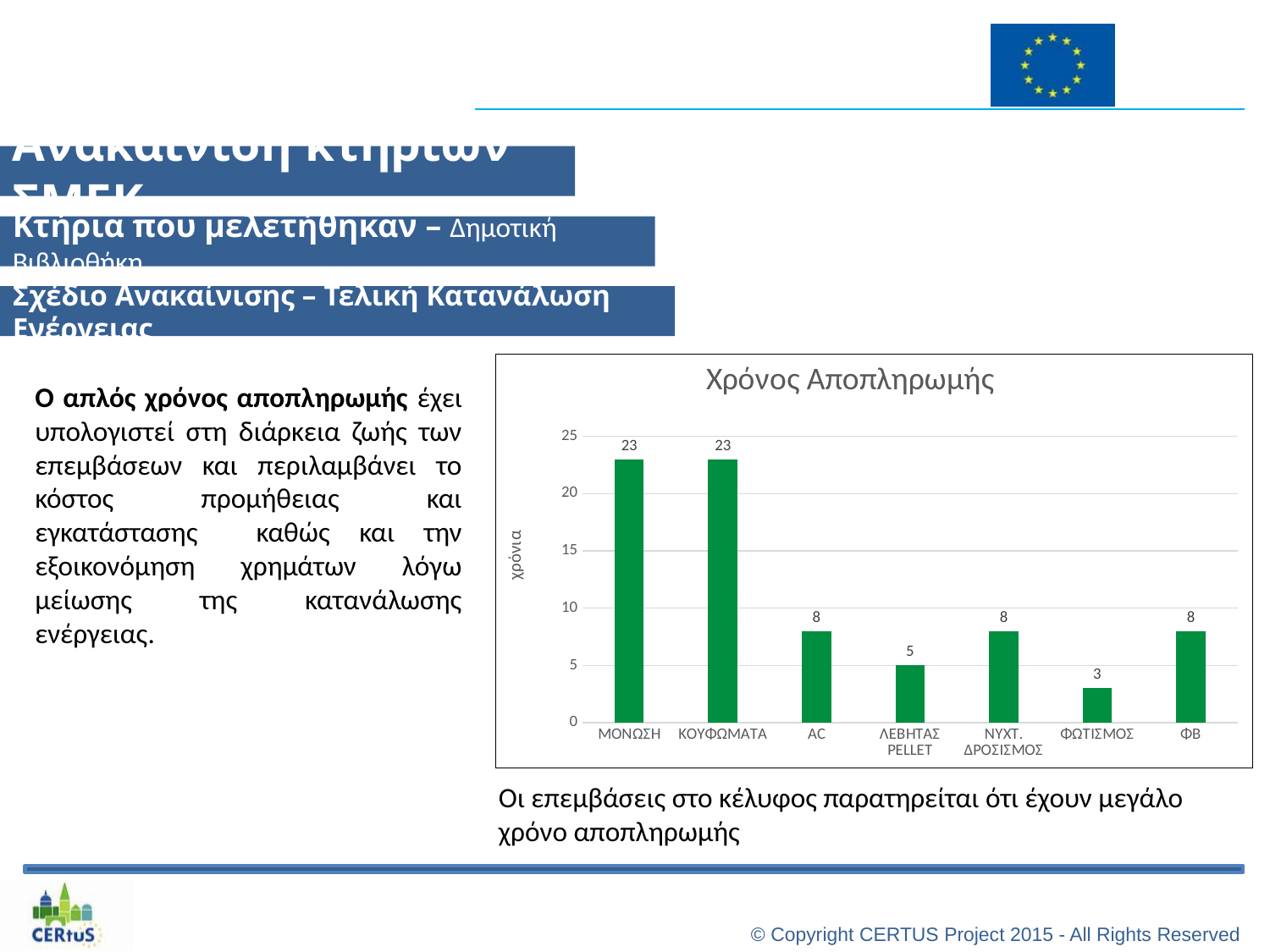
What is the value for ΦΩΤΙΣΜΟΣ in the Χρόνος Αποπληρωμής chart? 3 How many categories are shown in the Χρόνος Αποπληρωμής chart? 7 Which category has the lowest value in the Χρόνος Αποπληρωμής chart? ΦΩΤΙΣΜΟΣ Which is larger in the Χρόνος Αποπληρωμής chart, the value for ΜΟΝΩΣΗ or the value for ΛΕΒΗΤΑΣ PELLET? ΜΟΝΩΣΗ What is the value for ΦΒ in the Χρόνος Αποπληρωμής chart? 8 Is the value for ΚΟΥΦΩΜΑΤΑ in the Χρόνος Αποπληρωμής chart greater or less than 20? greater What kind of chart is the Χρόνος Αποπληρωμής chart? bar chart What is the label of the vertical axis in the Χρόνος Αποπληρωμής chart? χρόνια What is the difference between the values for ΝΥΧΤ. ΔΡΟΣΙΣΜΟΣ and ΦΩΤΙΣΜΟΣ in the Χρόνος Αποπληρωμής chart? 5 What is the value for ΜΟΝΩΣΗ in the Χρόνος Αποπληρωμής chart? 23 What is the difference between the values for ΚΟΥΦΩΜΑΤΑ and AC in the Χρόνος Αποπληρωμής chart? 15 What is the value for ΛΕΒΗΤΑΣ PELLET in the Χρόνος Αποπληρωμής chart? 5